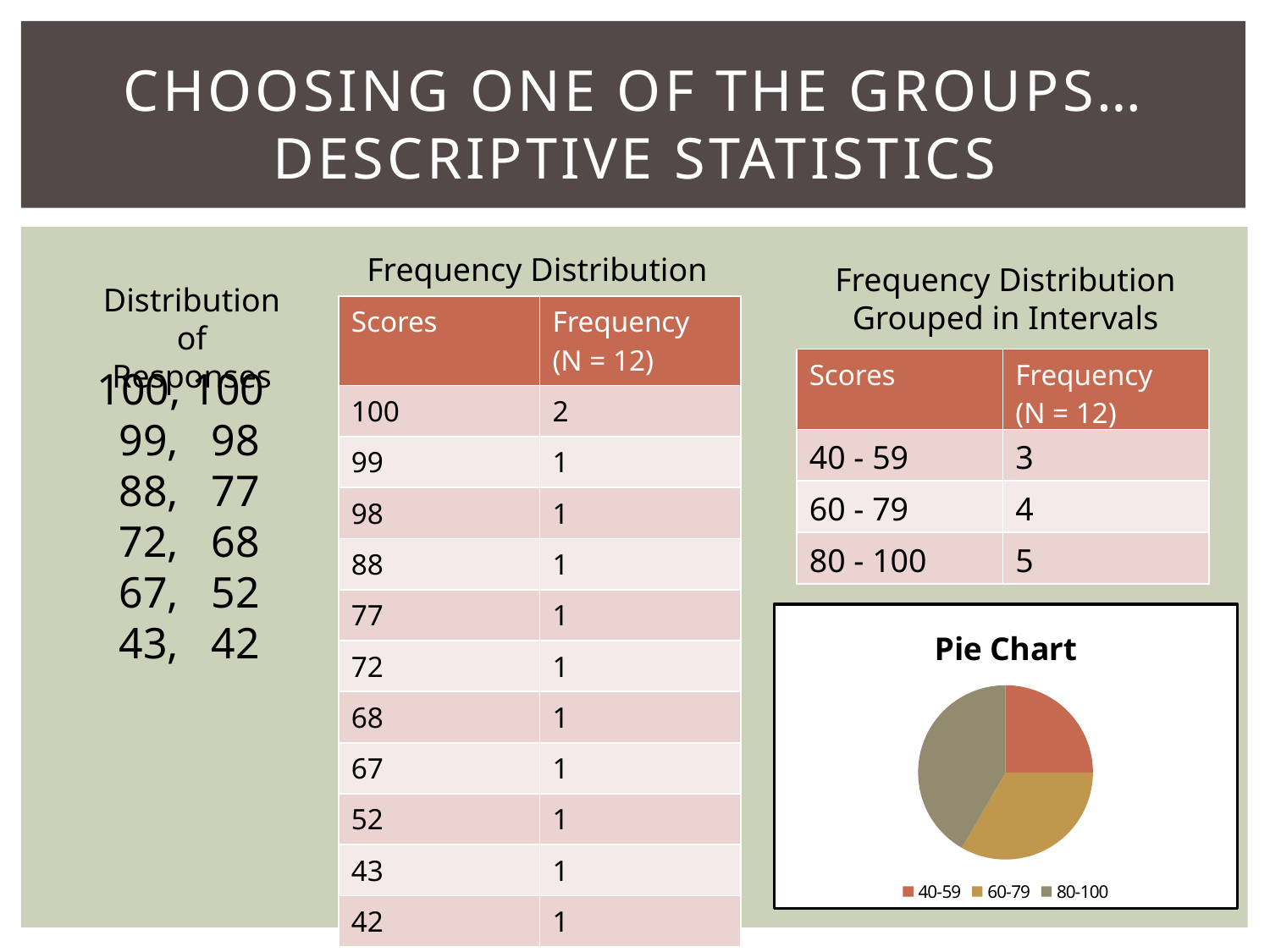
How many slices does the pie chart have? 3 Which category has the largest slice in the pie chart? 80-100 In the pie chart, which slice is larger, 60-79 or 80-100? 80-100 Which category has the smallest slice in the pie chart? 40-59 Which category is shown in the red-orange colour in the pie chart? 40-59 What kind of chart is shown on the slide? pie chart What are the three categories listed in the pie chart's legend? 40-59, 60-79, 80-100 In the pie chart, which slice is larger, 40-59 or 60-79? 60-79 How many entries does the pie chart's legend list? 3 What is the title of the chart on the slide? Pie Chart